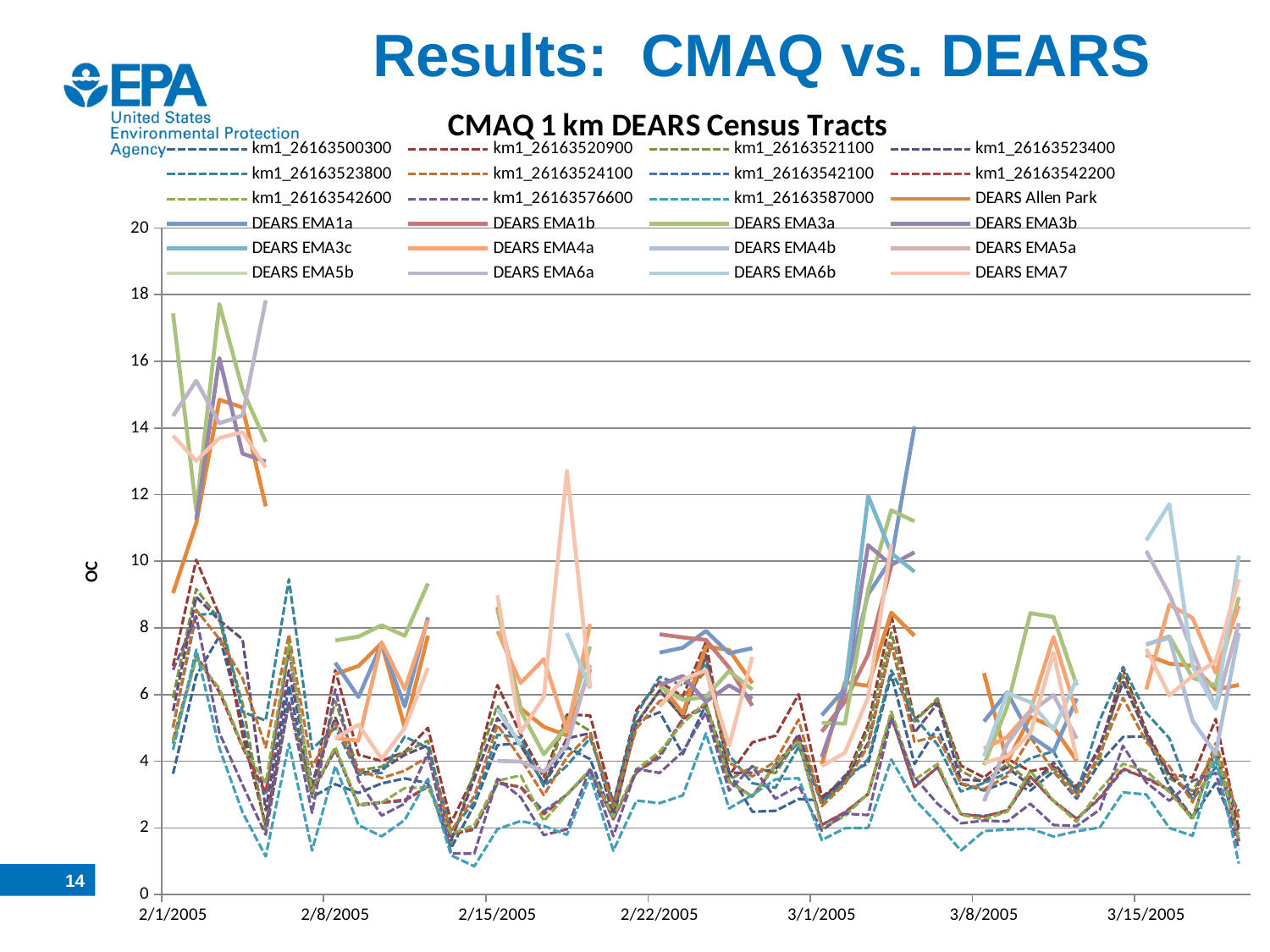
Is the highest plotted value on the chart greater or less than 20? less Is the lowest plotted value on the chart greater or less than 2? less How many series does the chart's legend list in total? 24 What kind of chart is shown on the slide? line chart How many series in the legend have names beginning with "km1_"? 11 What is the first date label on the x axis? 2/1/2005 How many date labels are shown along the x axis? 7 How many series in the legend have names beginning with "DEARS"? 13 What is the label on the vertical axis of the chart? OC What is the title of the chart? CMAQ 1 km DEARS Census Tracts Is the highest plotted value on the chart greater or less than 16? greater